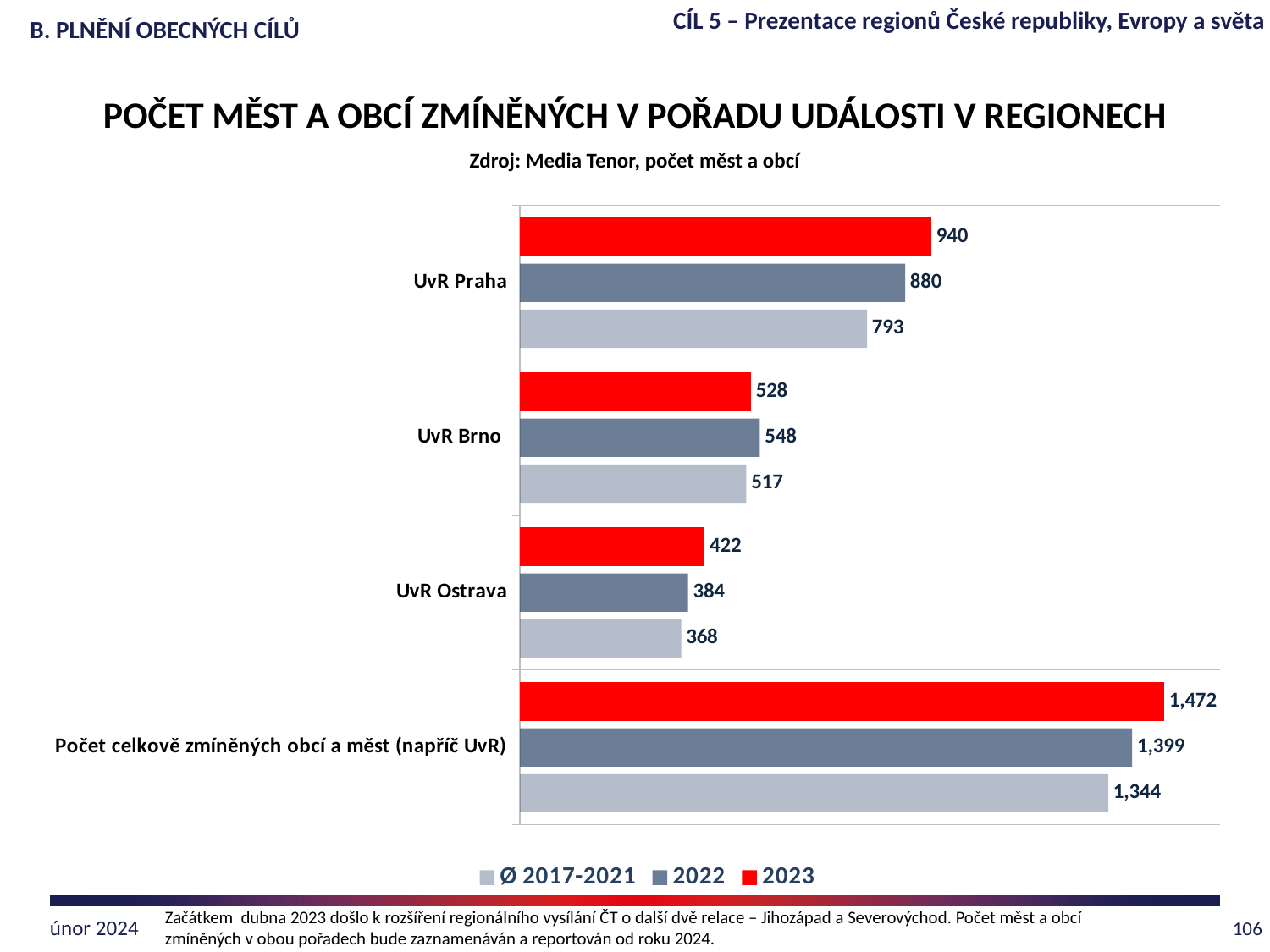
What is the 2023 value for Počet celkově zmíněných obcí a měst (napříč UvR)? 1,472 How many series does the legend list? 3 For UvR Brno, which is larger: the 2022 value or the 2023 value? 2022 What is the 2022 value for UvR Brno? 548 Among the three UvR categories, which has the lowest Ø 2017-2021 value? UvR Ostrava What is the 2023 value for UvR Praha? 940 How many categories are shown on the chart? 4 What is the difference between the 2023 and 2022 values for UvR Praha? 60 What is the Ø 2017-2021 value for UvR Ostrava? 368 Which colour represents the 2023 series in the legend? red Which category has the highest 2023 value? Počet celkově zmíněných obcí a měst (napříč UvR) What kind of chart is shown on the slide? bar chart